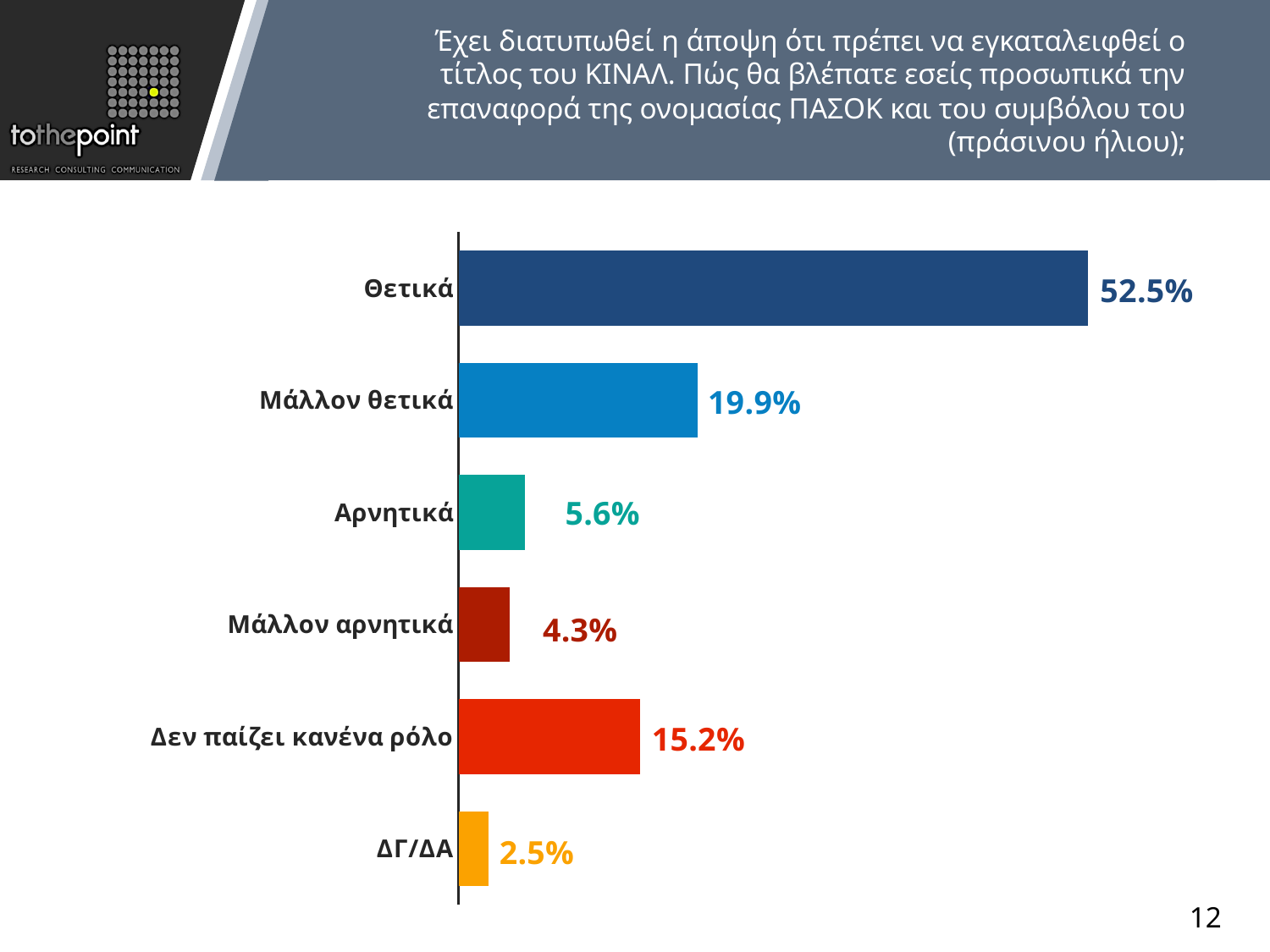
Which category has the lowest value? ΔΓ/ΔΑ What colour is the bar for ΔΓ/ΔΑ? Orange How many categories are shown in the chart? 6 What is the value for ΔΓ/ΔΑ? 2.5% What kind of chart is shown on the slide? Bar chart What is the value for Δεν παίζει κανένα ρόλο? 15.2% Which is larger, the value for Μάλλον θετικά or the value for Δεν παίζει κανένα ρόλο? Μάλλον θετικά What is the difference between the values for Αρνητικά and Μάλλον αρνητικά? 1.3% Which category has the highest value? Θετικά What is the difference between the values for Θετικά and Μάλλον θετικά? 32.6% What is the value for Μάλλον θετικά? 19.9% What is the value for Θετικά? 52.5%